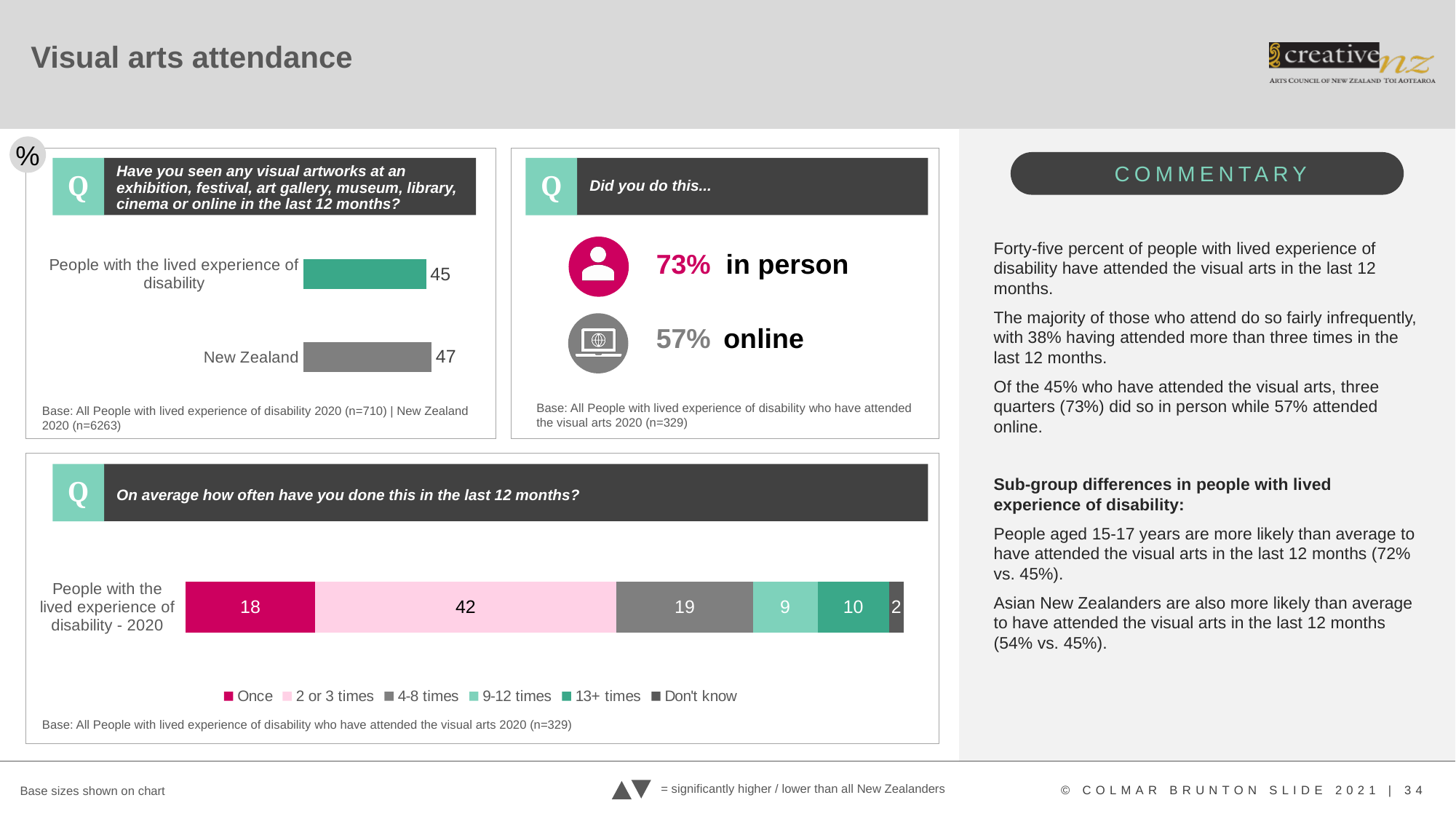
In the bottom chart (On average how often have you done this...), what is the value for 2 or 3 times? 42 In the bottom chart (On average how often have you done this...), what is the value for 13+ times? 10 What kind of chart is the bottom chart (On average how often have you done this...)? Stacked bar chart In the top-left chart (Have you seen any visual artworks...), what is the value for People with the lived experience of disability? 45 In the bottom chart (On average how often have you done this...), what is the total of the stacked bar? 100 In the top-left chart (Have you seen any visual artworks...), what is the difference between the New Zealand value and the value for People with the lived experience of disability? 2 In the top-left chart (Have you seen any visual artworks...), how many categories are shown? 2 In the bottom chart (On average how often have you done this...), which segment is the smallest? Don't know In the bottom chart (On average how often have you done this...), how many series does the legend list? 6 In the top-left chart (Have you seen any visual artworks...), what is the value for New Zealand? 47 In the top-left chart (Have you seen any visual artworks...), which category has the higher value? New Zealand In the bottom chart (On average how often have you done this...), which segment is the largest? 2 or 3 times